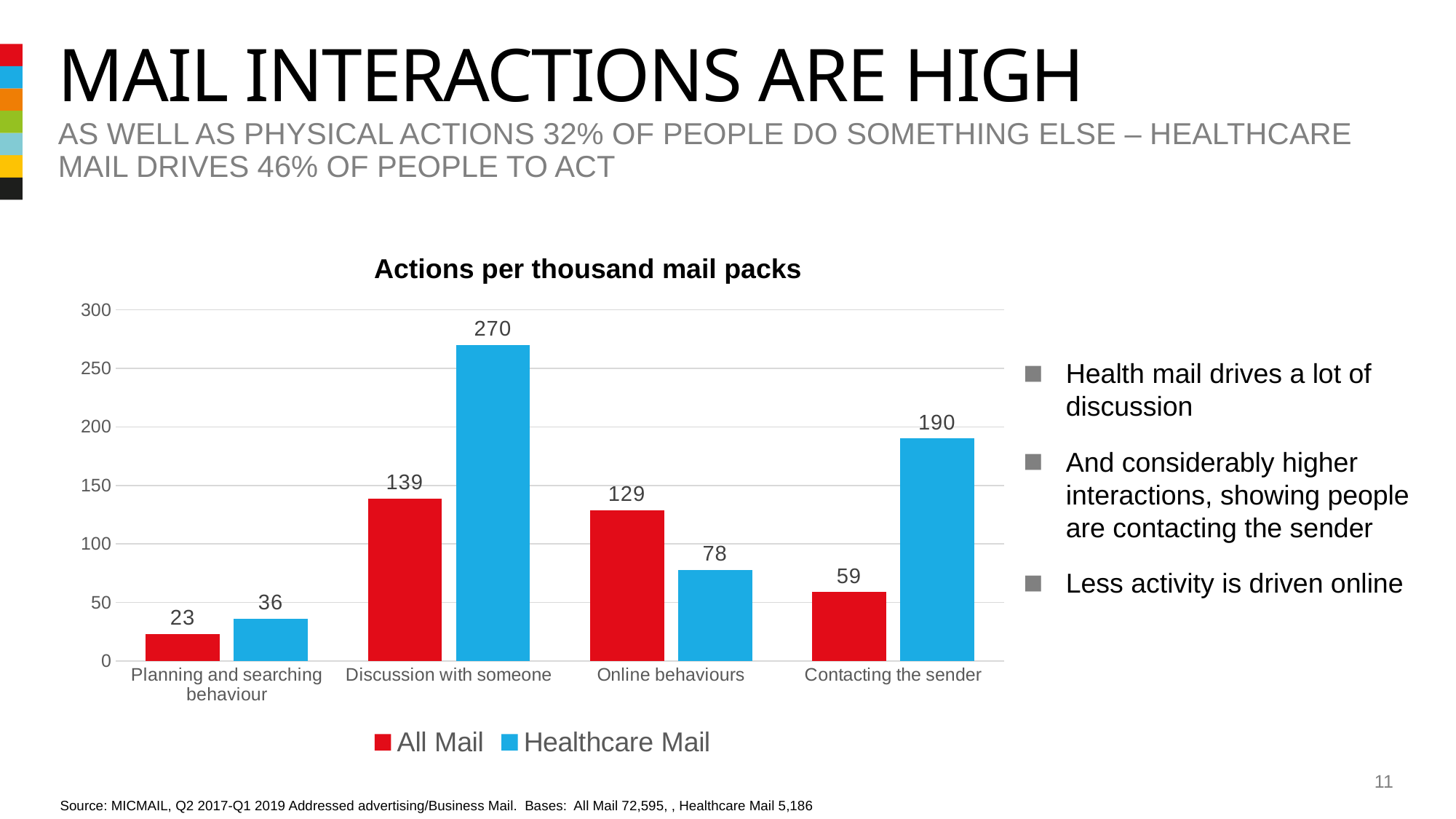
What is the title of the chart? Actions per thousand mail packs Which category has the lowest All Mail value? Planning and searching behaviour What is the difference between the Healthcare Mail and All Mail values for Contacting the sender? 131 Which category has the highest Healthcare Mail value? Discussion with someone What is the All Mail value for Online behaviours? 129 What kind of chart is shown on the slide? Bar chart What is the All Mail value for Planning and searching behaviour? 23 What is the Healthcare Mail value for Discussion with someone? 270 How many categories are shown on the x axis? 4 Is the Healthcare Mail value for Contacting the sender greater or less than 150? greater How many series does the legend list? 2 For Online behaviours, which series has the larger value, All Mail or Healthcare Mail? All Mail